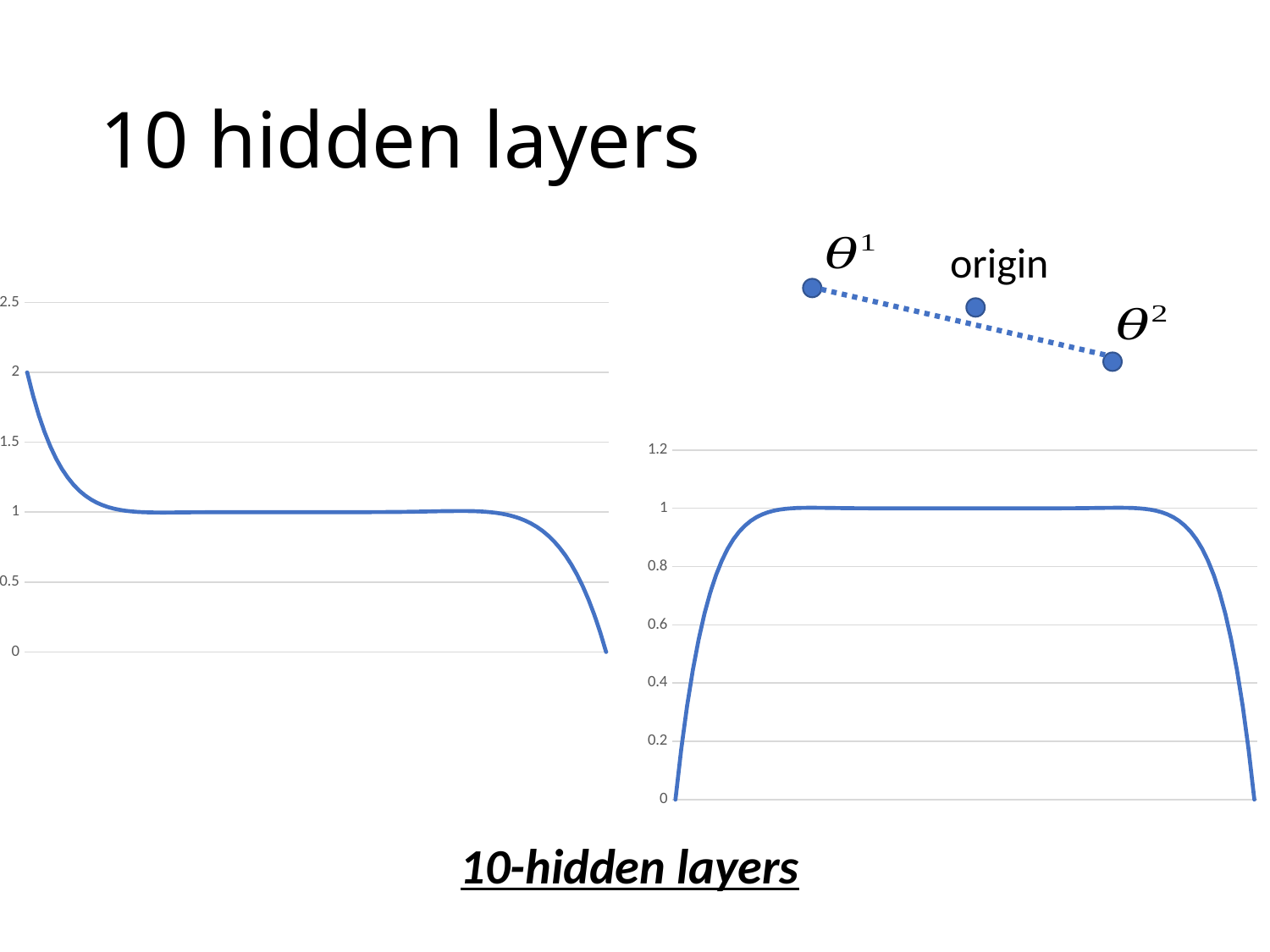
What is the highest value shown on the y axis of the right chart? 1.2 What kind of chart is the chart on the left of the slide? line chart What is the highest value shown on the y axis of the left chart? 2.5 On the right chart, what is the value of the line at its leftmost point? 0 On the left chart, does the line rise or fall from its leftmost point to its rightmost point? fall What kind of chart is the chart on the right of the slide? line chart On the right chart, is the value of the line in the flat middle section greater or less than 0.8? greater On the left chart, is the value of the line in the flat middle section greater or less than 1.5? less On the left chart, what is the value of the line at its leftmost point? 2 On the right chart, does the line rise or fall at the far right end of the x axis? fall On the right chart, what is the value of the line at its rightmost point? 0 On the left chart, what is the value of the line at its rightmost point? 0